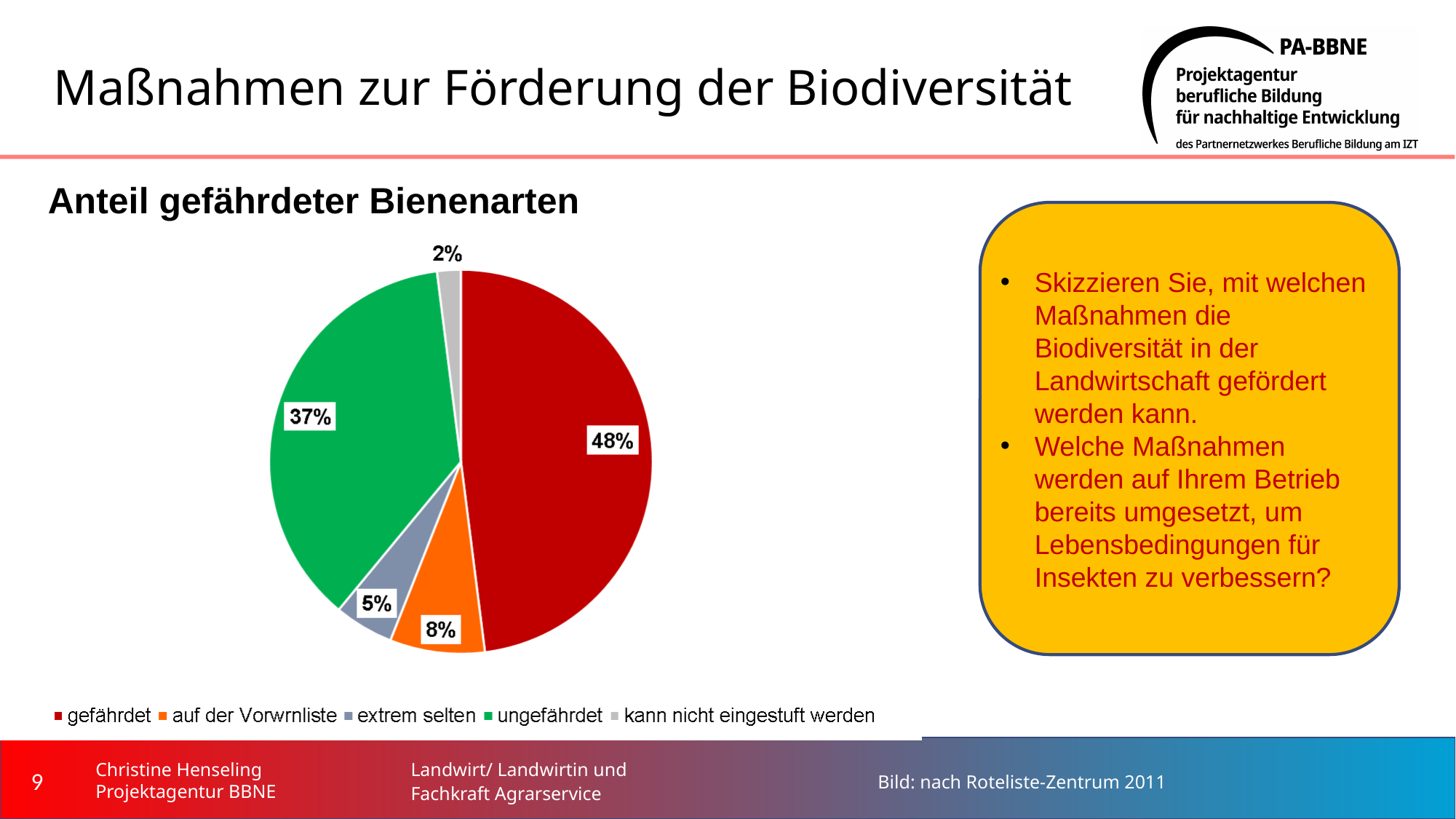
Which is larger, the "auf der Vorwrnliste" slice or the "extrem selten" slice? auf der Vorwrnliste What percentage is shown for "extrem selten"? 5% How many slices does the pie chart have? 5 Which category has the smallest slice of the pie? kann nicht eingestuft werden Which category has the largest slice of the pie? gefährdet What type of chart is shown on the slide? pie chart What share is given for "kann nicht eingestuft werden"? 2% What share of bee species is labelled "gefährdet" in the pie chart? 48% What percentage does the "ungefährdet" slice show? 37% What colour is the "ungefährdet" slice? green What is the difference in percentage points between "gefährdet" and "ungefährdet"? 11 What is the value of the "auf der Vorwrnliste" slice? 8%